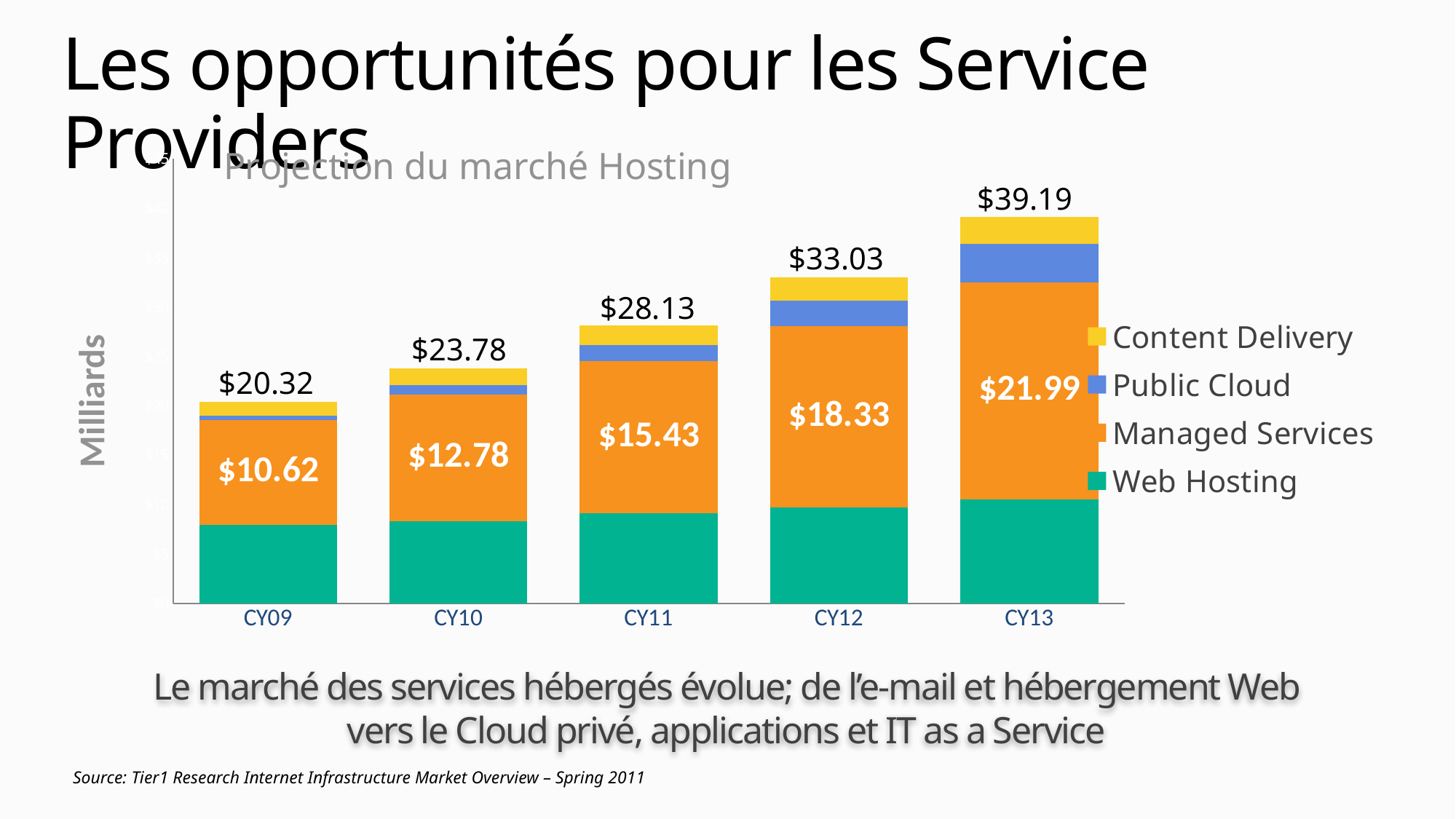
What is the total value of the CY13 bar? $39.19 How many series does the legend list? 4 What is the difference between the Managed Services value for CY13 and for CY09? $11.37 Do the total values rise or fall from CY09 to CY13? rise What is the Managed Services value for CY12? $18.33 Which year has the lowest Managed Services value? CY09 How many years are shown on the x axis? 5 Which year has the highest total? CY13 What is the total value of the CY09 bar? $20.32 What is the Managed Services value for CY11? $15.43 Which is larger, the total for CY10 or the total for CY11? CY11 What is the difference between the total for CY13 and the total for CY09? $18.87